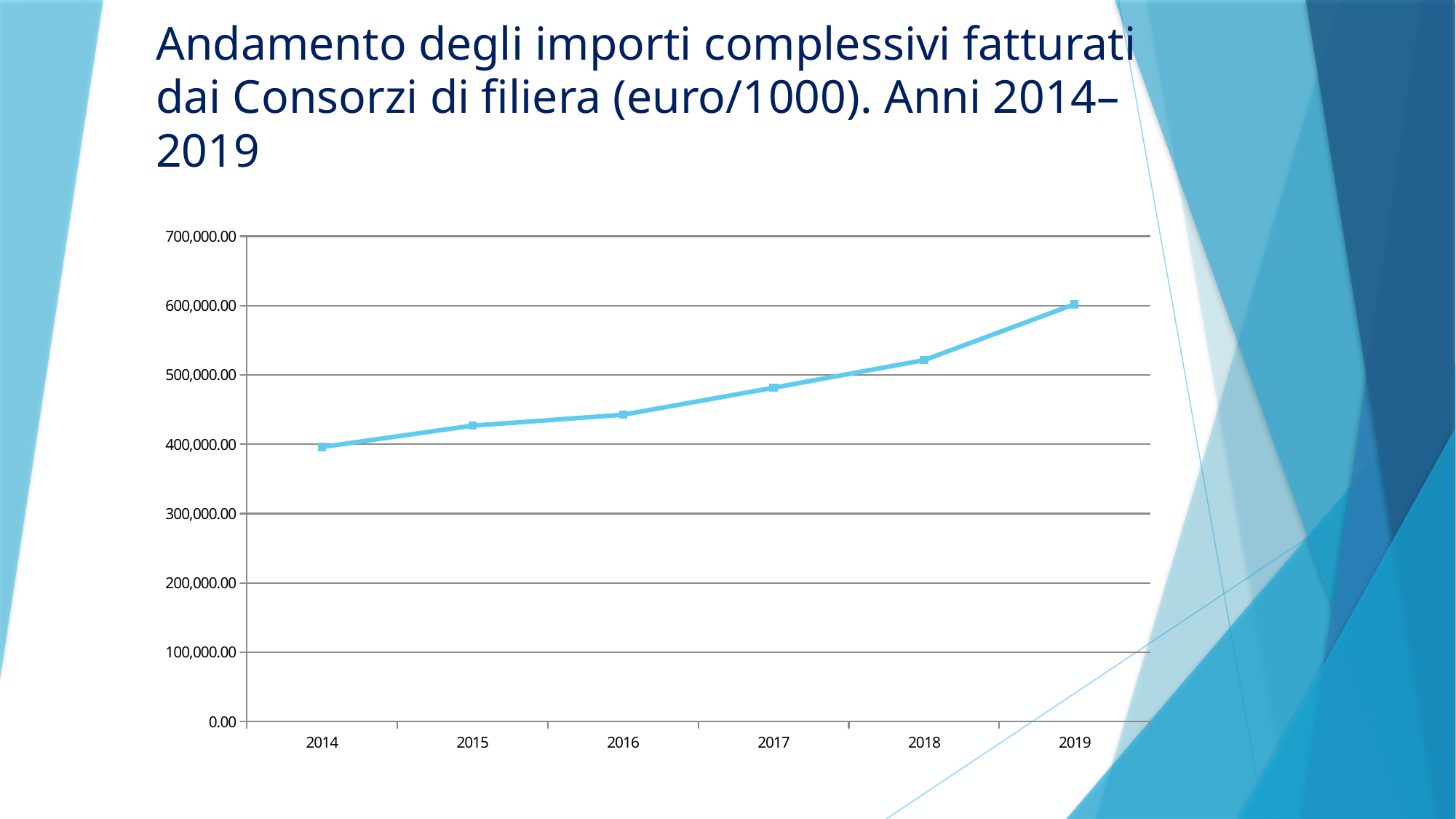
Is the value for 2019 greater or less than 500,000.00? greater Is the value for 2016 greater or less than 400,000.00? greater Which year has the larger value, 2016 or 2018? 2018 What is the first year shown on the x axis? 2014 Is the value for 2017 greater or less than 500,000.00? less What kind of chart is shown on the slide? line chart Which year has the highest value? 2019 Do the values rise or fall from 2014 to 2019? rise How many years (data points) are plotted on the x axis? 6 Which year has the lowest value? 2014